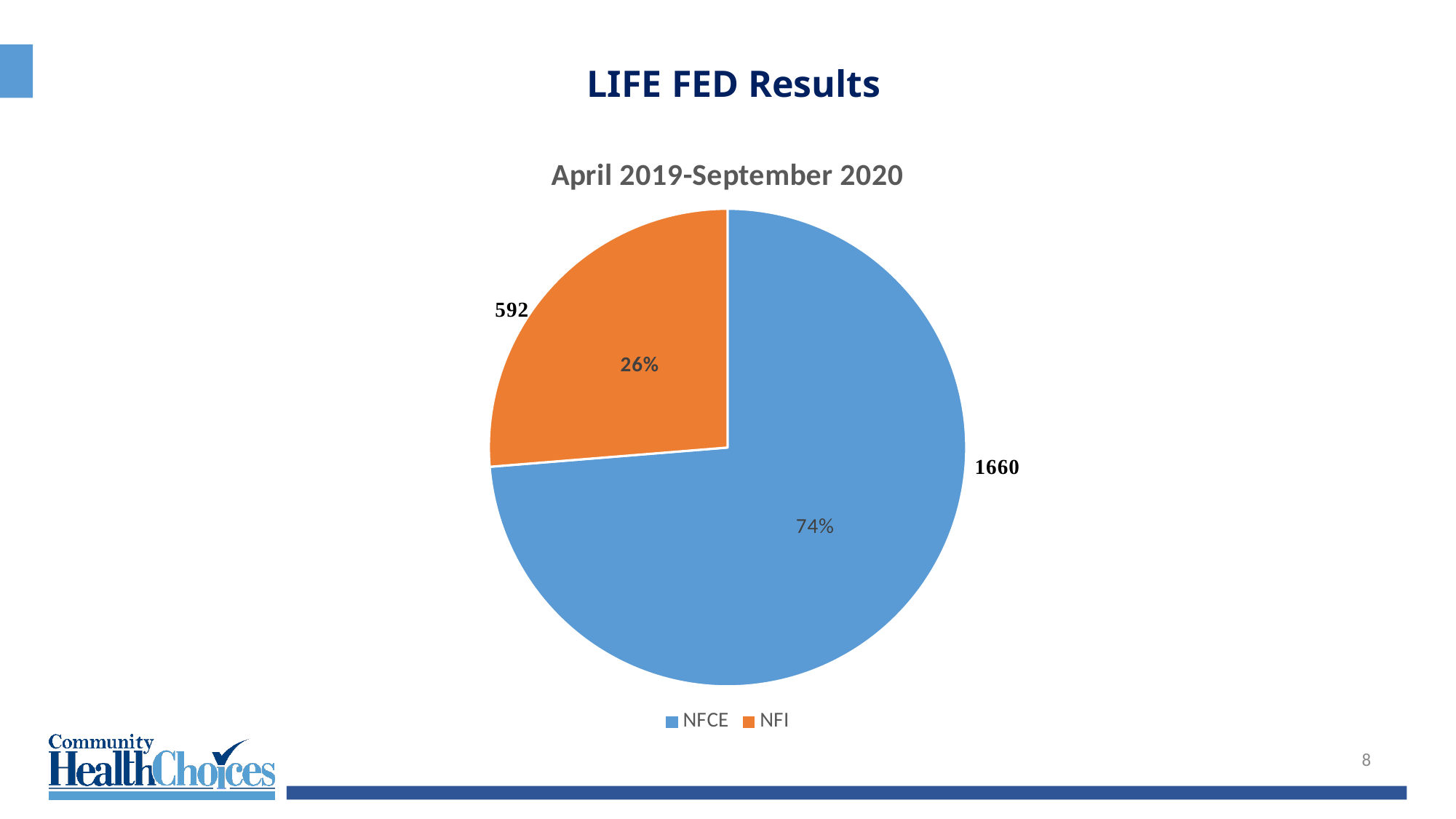
Which category has the smallest slice? NFI Which is larger, NFCE or NFI? NFCE What colour is the NFI slice? orange How many categories does the pie chart show? 2 What is the value for NFI? 592 What is the title of the chart? April 2019-September 2020 What is the difference between the NFCE value and the NFI value? 1068 What type of chart is shown on the slide? pie chart What percentage share of the pie does NFCE have? 74% Which category has the largest slice? NFCE What percentage share of the pie does NFI have? 26% What is the value for NFCE? 1660